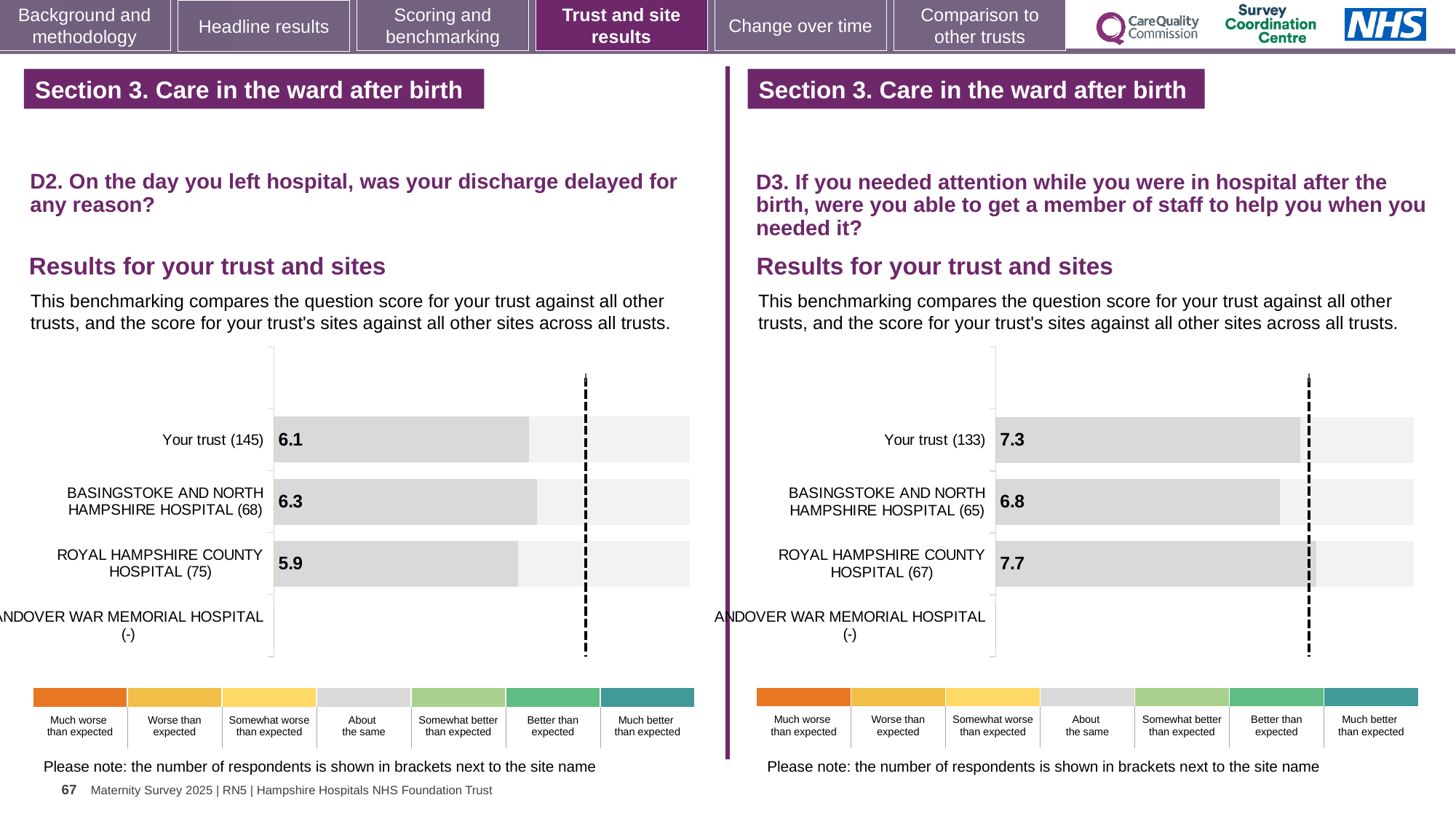
In the right chart (D3), what is the score for Royal Hampshire County Hospital? 7.7 What type of chart is used on the left side of the slide (D2)? Bar chart In the left chart (D2), which site or trust row has the lowest score? Royal Hampshire County Hospital In the right chart (D3, able to get a member of staff to help), what is the score for Your trust? 7.3 In the left chart (D2), which has the larger score: Your trust or Basingstoke and North Hampshire Hospital? Basingstoke and North Hampshire Hospital How many respondents are shown in brackets for Your trust in the right chart (D3)? 133 In the left chart (D2), what is the score for Basingstoke and North Hampshire Hospital? 6.3 In the right chart (D3), which site or trust row has the highest score? Royal Hampshire County Hospital In the right chart (D3), what is the difference between the scores for Royal Hampshire County Hospital and Basingstoke and North Hampshire Hospital? 0.9 In the left chart (D2), how many rows (trust and sites) are listed on the axis? 4 In the left chart (D2), what is the score for Royal Hampshire County Hospital? 5.9 In the left chart (D2, discharge delayed), what is the score for Your trust? 6.1